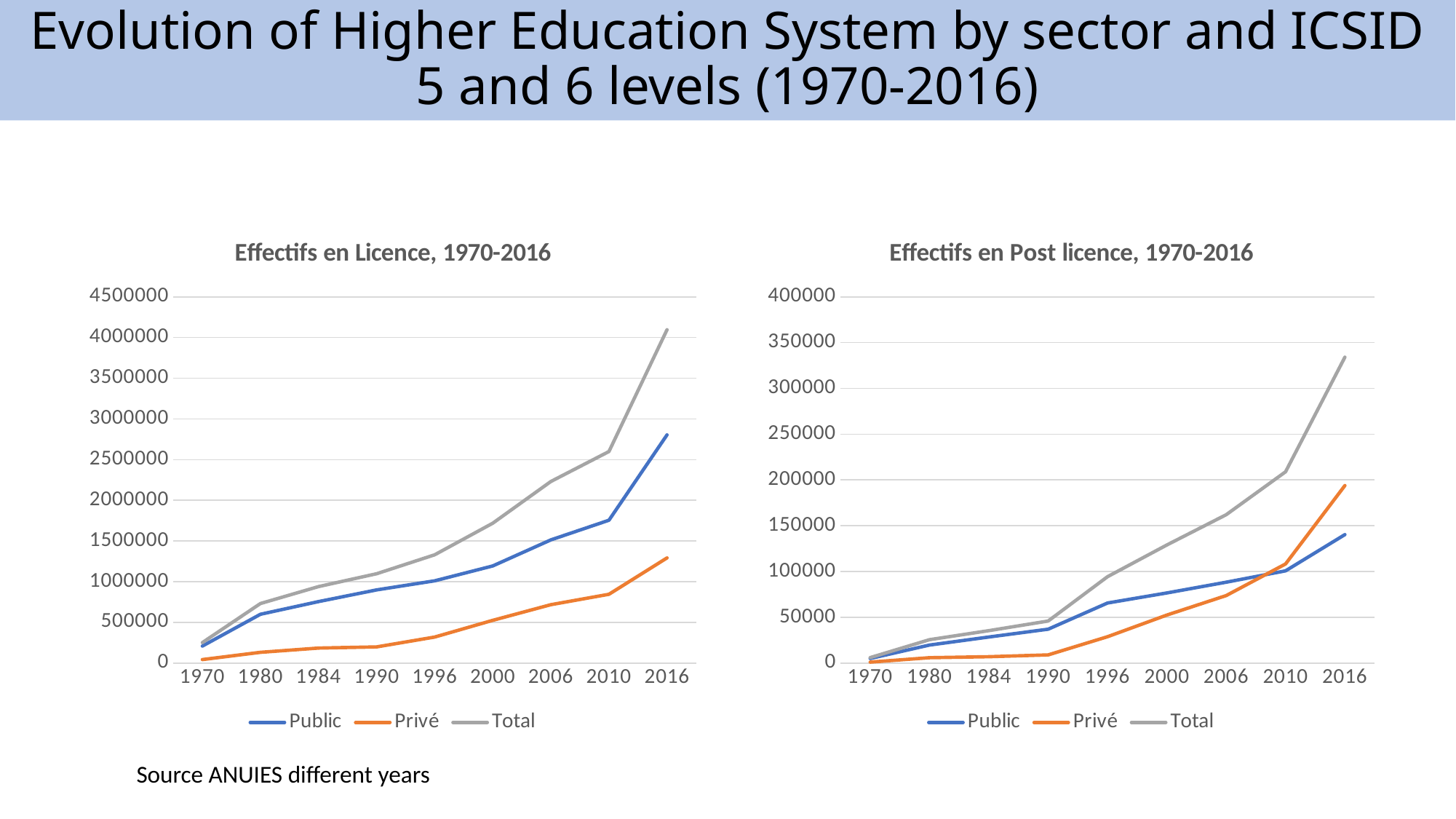
In the 'Effectifs en Licence, 1970-2016' chart, is the Total value for 2016 greater or less than 3500000? greater In the 'Effectifs en Licence, 1970-2016' chart, does the Total series rise or fall from 1970 to 2016? rise What kind of chart is the 'Effectifs en Licence, 1970-2016' chart? line chart Which series is drawn in grey in the 'Effectifs en Post licence, 1970-2016' chart? Total In the 'Effectifs en Post licence, 1970-2016' chart, is the Total value for 2016 greater or less than 300000? greater In the 'Effectifs en Post licence, 1970-2016' chart, which series is higher in 2016, Public or Privé? Privé In the 'Effectifs en Licence, 1970-2016' chart, is the Privé value for 1990 greater or less than 500000? less In the 'Effectifs en Licence, 1970-2016' chart, which series is higher in 2016, Public or Privé? Public How many years are shown on the x axis of the 'Effectifs en Licence, 1970-2016' chart? 9 How many series does the legend of the 'Effectifs en Post licence, 1970-2016' chart list? 3